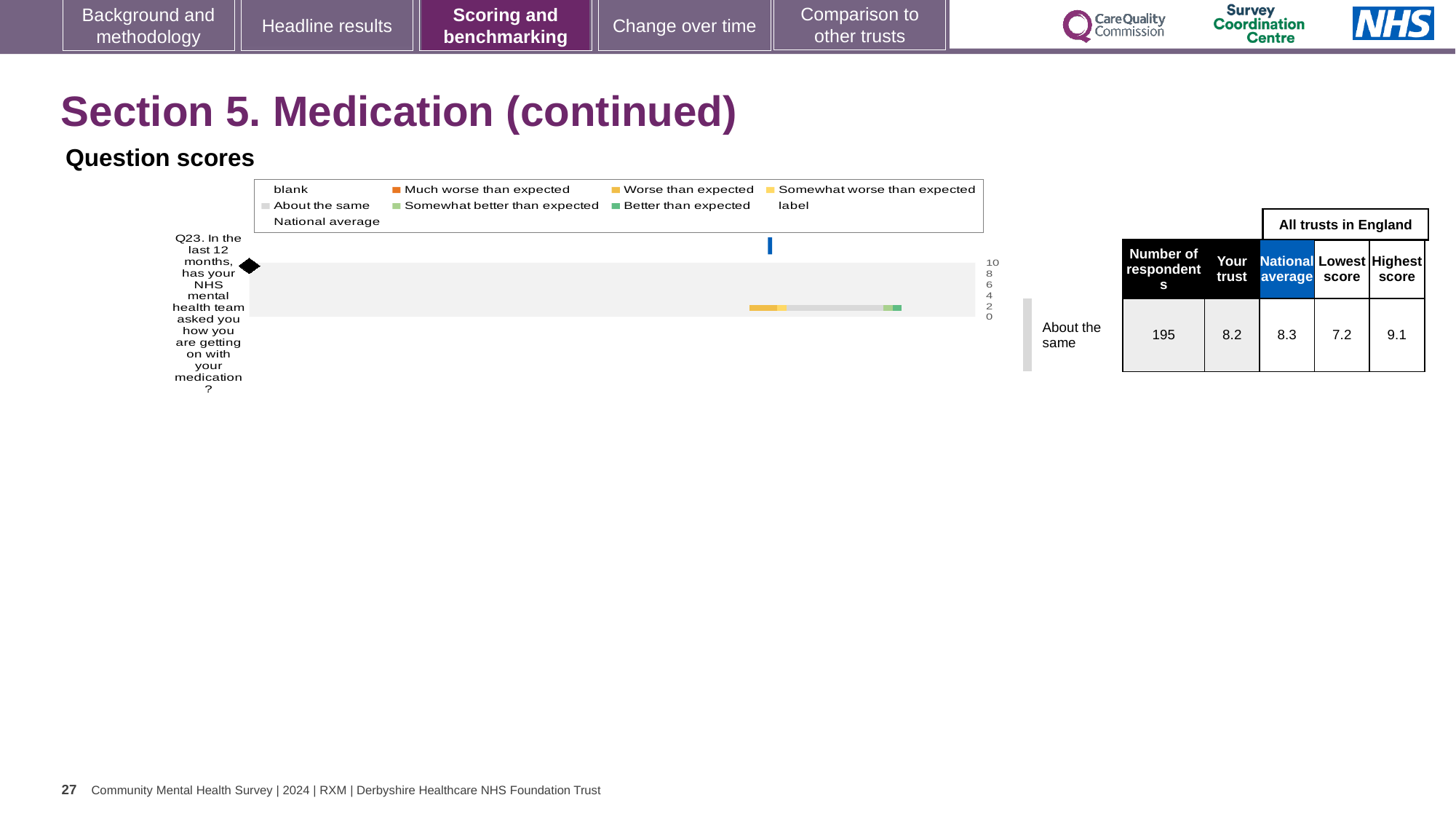
Which question is plotted in the Question scores chart? Q23. In the last 12 months, has your NHS mental health team asked you how you are getting on with your medication? How many questions are plotted in the Question scores chart? 1 In the table beside the chart, what is the 'Your trust' score for Q23? 8.2 In the table beside the chart, what is the Lowest score among all trusts in England for Q23? 7.2 What kind of chart is used to show the Q23 question score? bar chart What is the highest tick value shown on the axis of the Question scores chart? 10 Is the 'Your trust' score for Q23 larger or smaller than the National average? smaller In the table beside the chart, what is the Highest score among all trusts in England for Q23? 9.1 In the table beside the chart, what is the National average score for Q23? 8.3 What benchmark category label is shown next to the bar for Q23? About the same In the table beside the chart, how many respondents answered Q23? 195 What is the difference between the Highest score and the Lowest score for Q23 in the table? 1.9